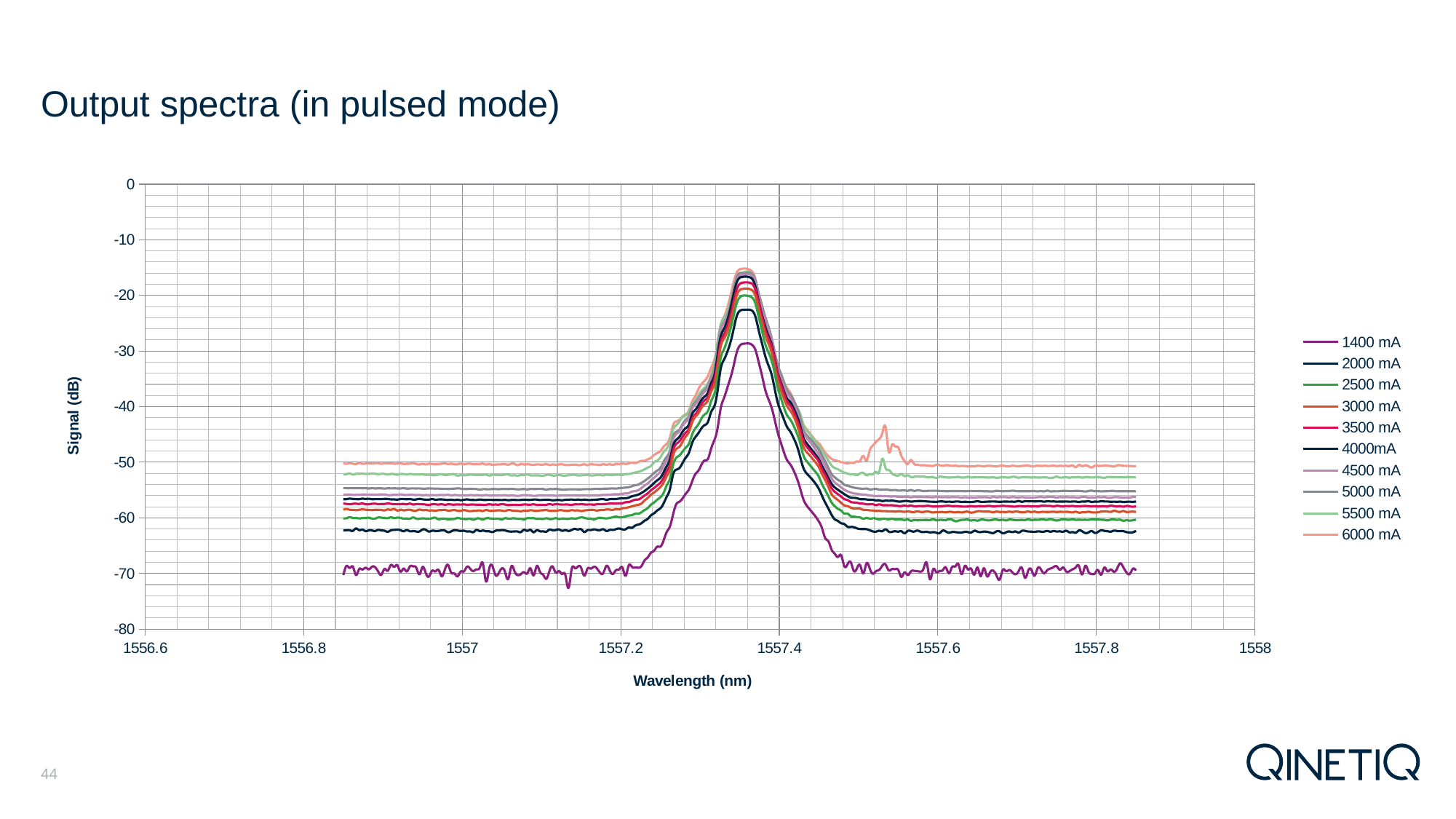
Which series has the higher peak signal, 1400 mA or 2000 mA? 2000 mA Which series has the highest baseline (noise floor) signal level away from the peak? 6000 mA Which series has the lowest peak signal? 1400 mA Is the peak signal of the 6000 mA series greater or less than -20 dB? greater What is the label of the x axis? Wavelength (nm) What is the title of the slide's chart? Output spectra (in pulsed mode) Is the baseline signal of the 1400 mA series at 1557 nm greater or less than -60 dB? less Is the peak signal of the 1400 mA series greater or less than -20 dB? less How many series does the legend list? 10 Which series has the lowest baseline signal level away from the peak? 1400 mA What kind of chart is shown on the slide? line chart